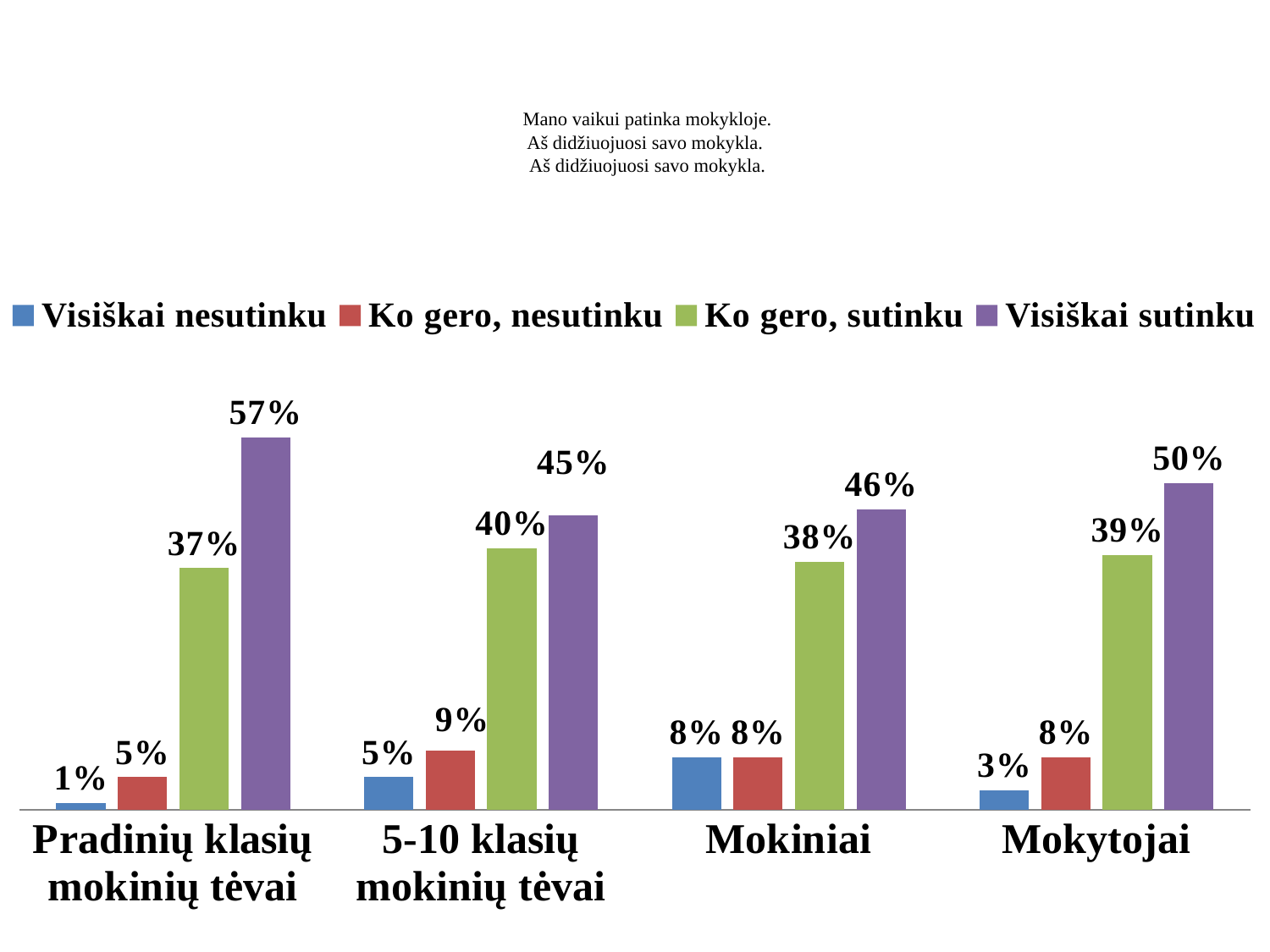
What is the value of "Ko gero, sutinku" for "5-10 klasių mokinių tėvai"? 40% How many series does the legend list? 4 How many categories are shown on the x axis? 4 What is the difference between the "Visiškai sutinku" values for "Pradinių klasių mokinių tėvai" and "Mokytojai"? 7% What is the value of "Visiškai sutinku" for "Pradinių klasių mokinių tėvai"? 57% What is the value of "Ko gero, nesutinku" for "Mokytojai"? 8% What kind of chart is shown on the slide? bar chart What is the value of "Visiškai nesutinku" for "Mokiniai"? 8% Which category has the highest value for "Visiškai sutinku"? Pradinių klasių mokinių tėvai Which is larger: the "Ko gero, sutinku" value for "Mokytojai" or for "Mokiniai"? Mokytojai Which legend entry is shown in green? Ko gero, sutinku Which category has the lowest value for "Visiškai nesutinku"? Pradinių klasių mokinių tėvai